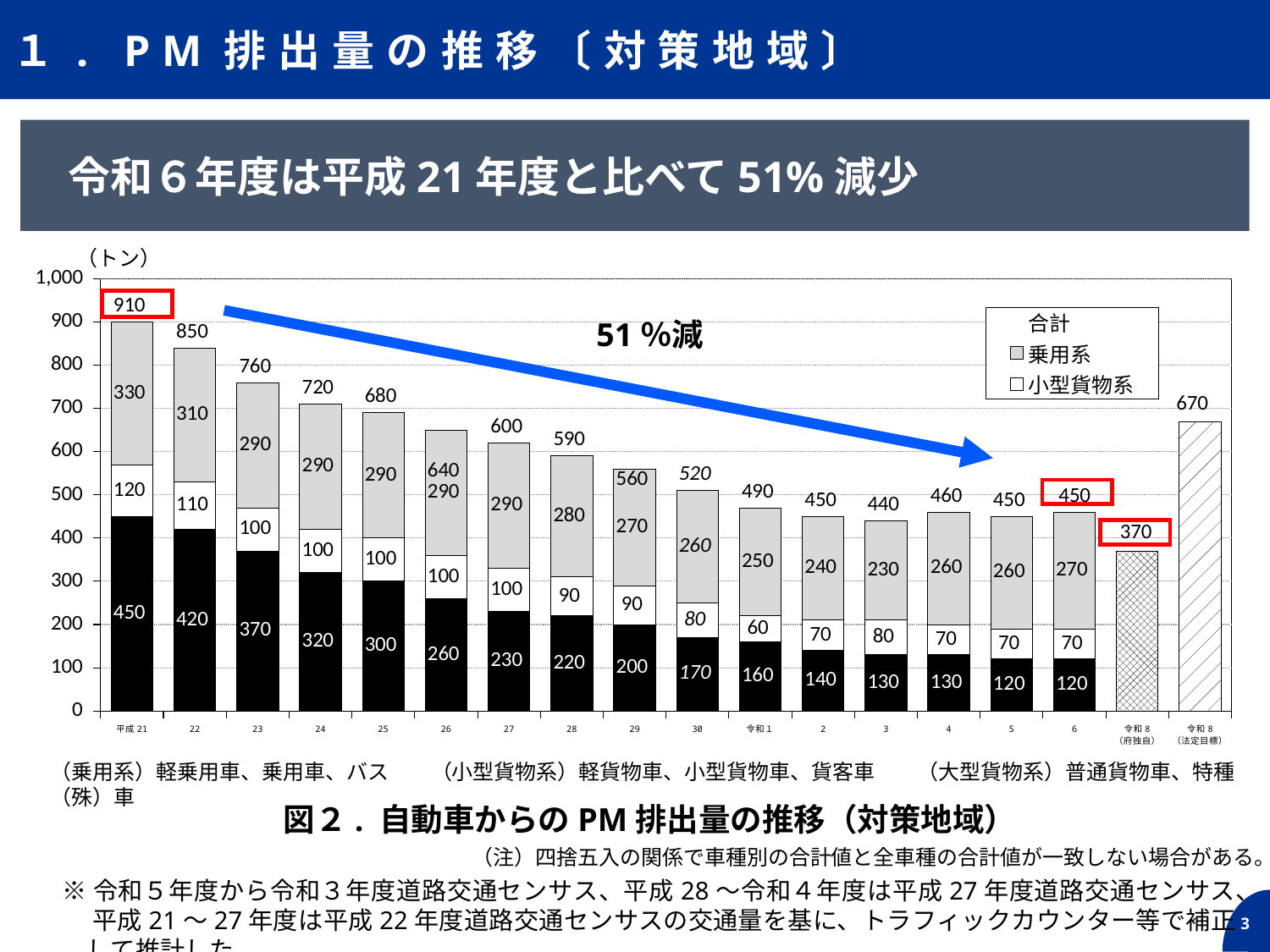
What kind of chart is shown on the slide? Stacked bar chart Which bar has the lowest total value on the chart? 令和8（府独自） Do the total values generally rise or fall from 平成21 to 令和6? Fall What is the 乗用系 value for 平成21? 330 What is the 小型貨物系 value for 令和1? 60 How many bars are plotted on the chart? 18 Which is larger, the 令和8（法定目標） bar or the 令和8（府独自） bar? 令和8（法定目標） What is the total PM emission value shown for 平成21? 910 What is the total PM emission value shown for 令和6? 450 Which year has the highest total PM emission value? 平成21 What is the difference between the total for 平成21 and the total for 令和6? 460 What unit is shown on the y axis of the chart? トン